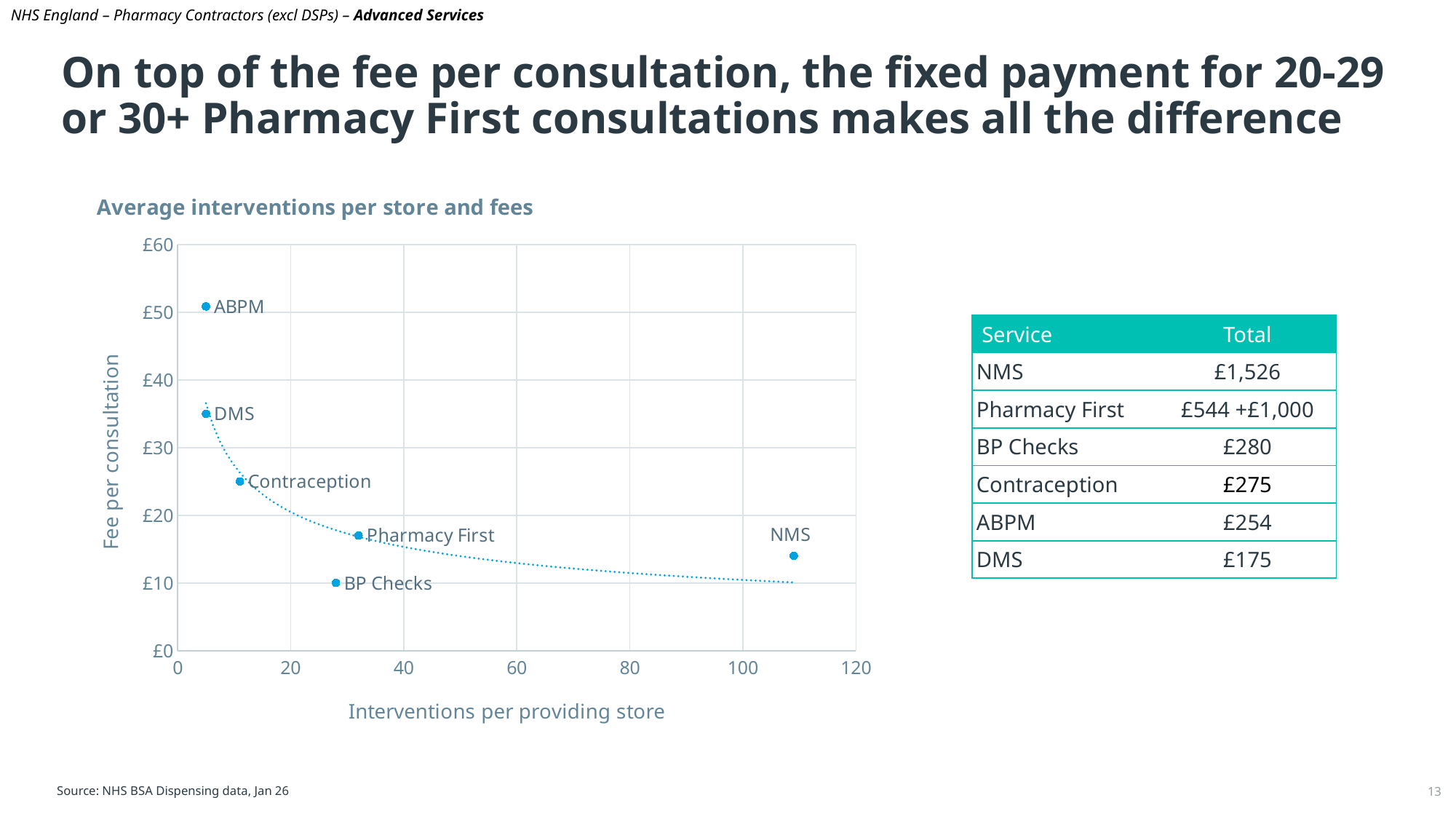
As interventions per providing store increase along the x axis, does the fee per consultation generally rise or fall? Fall Which service has the lowest fee per consultation? BP Checks What kind of chart is shown on the slide? Scatter chart Which service has the most interventions per providing store? NMS Is the fee per consultation for ABPM greater or less than £40? greater Is the fee per consultation for Pharmacy First greater or less than £20? less Is the number of interventions per providing store for NMS greater or less than 100? greater Which has more interventions per providing store, NMS or Pharmacy First? NMS How many services are plotted as points on the chart? 6 Which service has the highest fee per consultation? ABPM Which has the higher fee per consultation, ABPM or DMS? ABPM